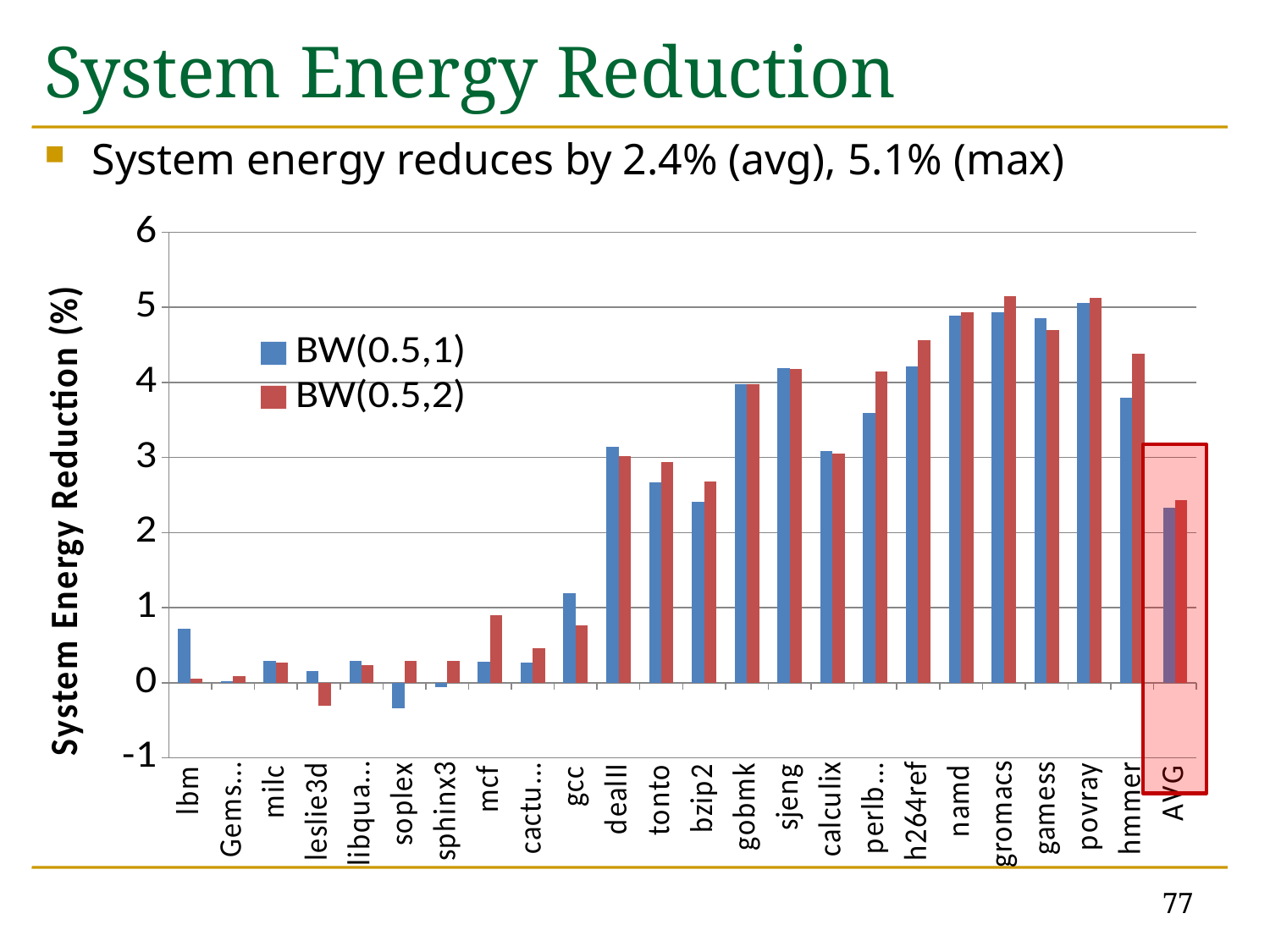
Is the BW(0.5,1) value for bzip2 greater or less than 3? less Is the BW(0.5,1) value for gcc greater or less than 1? greater Is the BW(0.5,2) value for hmmer greater or less than 4? greater Which category has the lowest value for the BW(0.5,1) series? soplex What is the label of the y axis? System Energy Reduction (%) How many series does the legend list? 2 For hmmer, which series has the larger value, BW(0.5,1) or BW(0.5,2)? BW(0.5,2) How many categories are shown along the x axis? 24 Which category has the lowest value for the BW(0.5,2) series? leslie3d For gcc, which series has the larger value, BW(0.5,1) or BW(0.5,2)? BW(0.5,1) What kind of chart is shown on the slide? bar chart